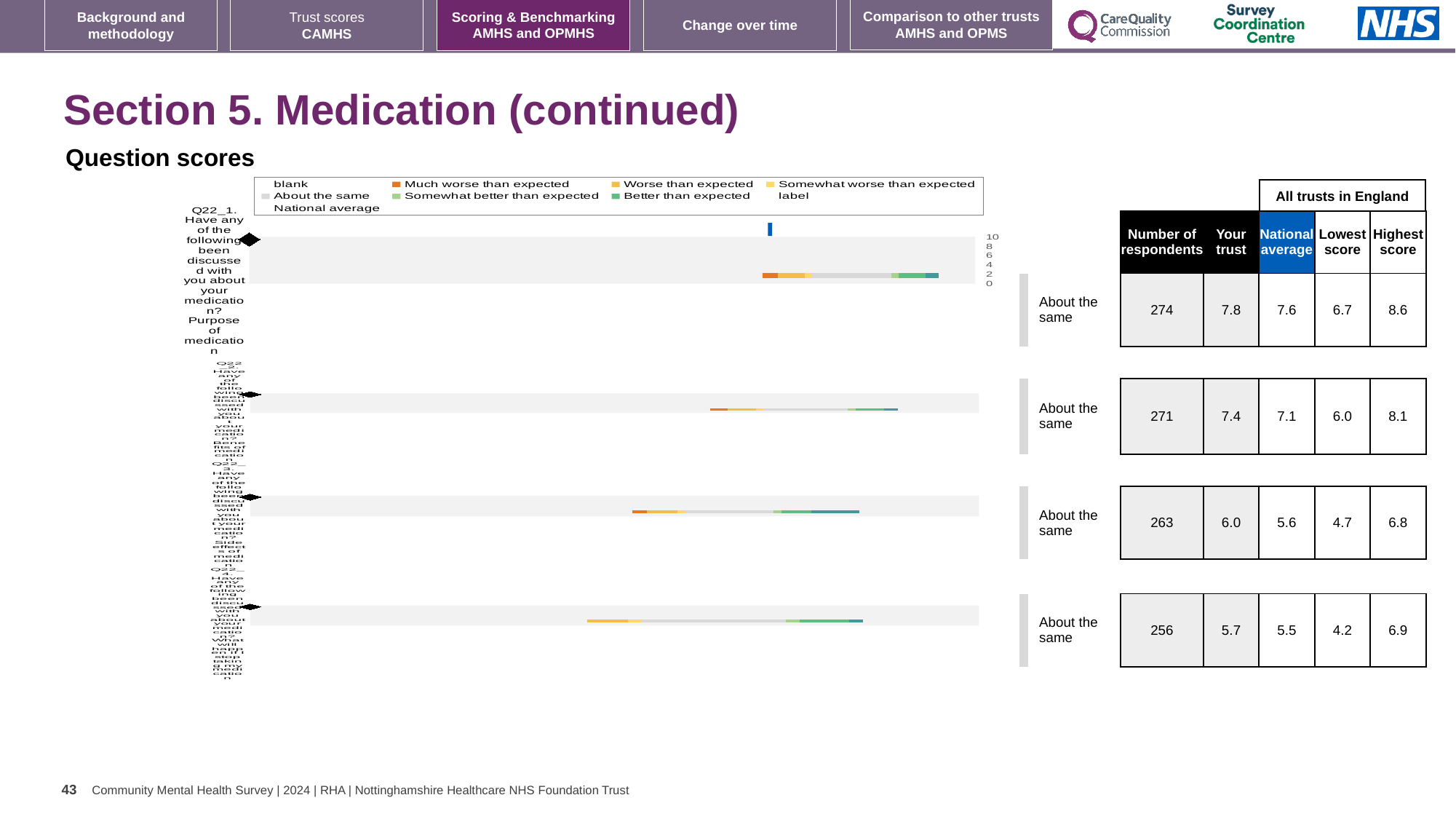
Which legend entry is shown in orange in the chart? Much worse than expected What is the national average for the first row (Q22_1, Purpose of medication)? 7.6 How many question bars are plotted in the chart? 4 What is the maximum value shown on the chart's axis scale? 10 What is the 'Your trust' score for the first row (Q22_1, Purpose of medication)? 7.8 What is the difference between 'Your trust' and the national average in the third row? 0.4 How many respondents are listed for the third row of the table? 263 What benchmark category is shown for all four rows? About the same Which row has the lowest 'Your trust' score? the fourth row (5.7) In the second row, is the 'Your trust' score or the national average larger? Your trust (7.4) Which row has the highest 'Highest score' value? the first row (8.6) What kind of chart is shown under 'Question scores'? bar chart